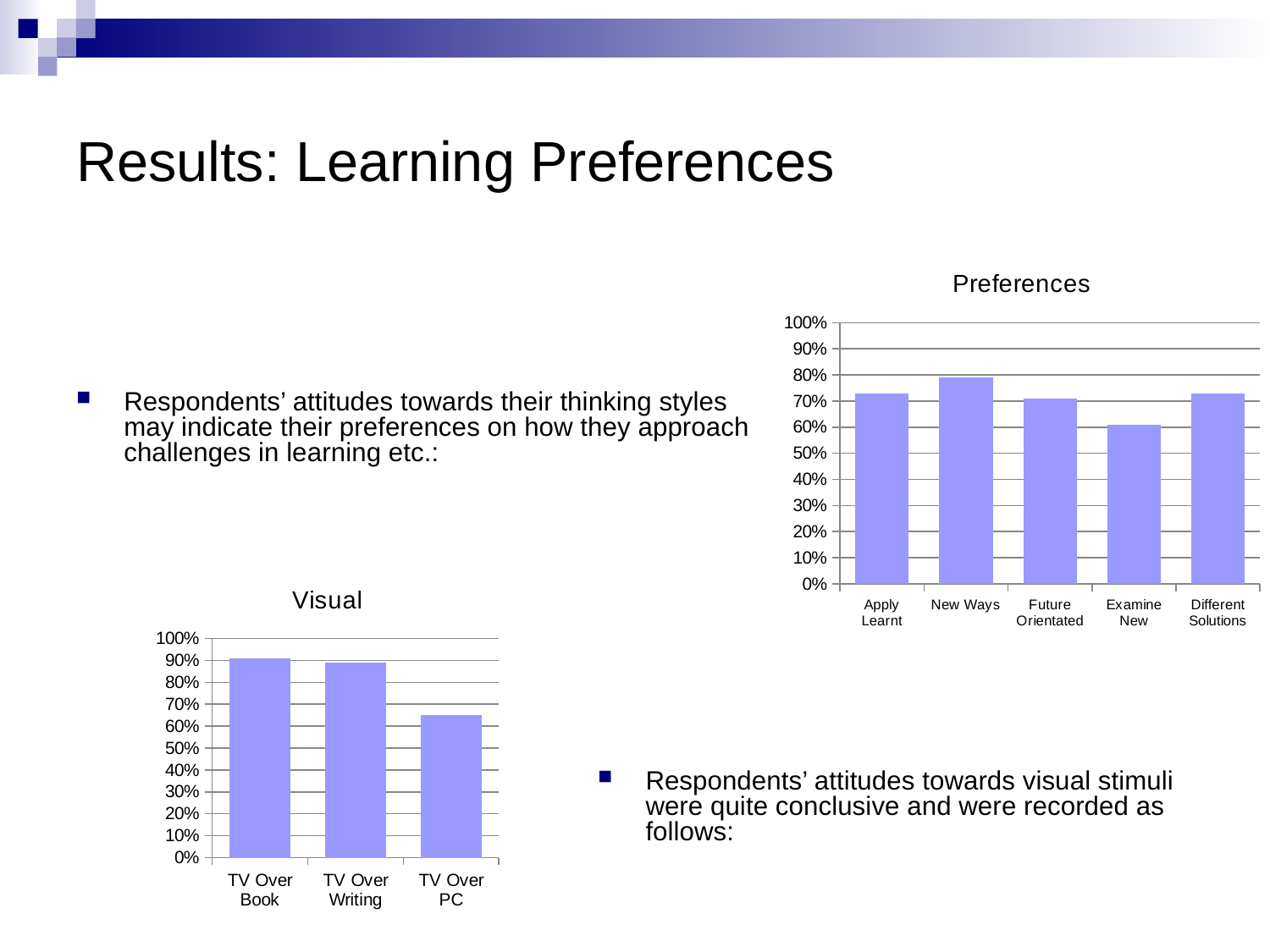
What kind of chart is the Preferences chart? bar chart In the Visual chart, which category has the lowest value? TV Over PC In the Preferences chart, which category has the highest value? New Ways In the Visual chart, which is larger, TV Over Writing or TV Over PC? TV Over Writing How many categories are shown in the Visual chart? 3 How many categories are shown in the Preferences chart? 5 In the Visual chart, is the value for TV Over Book greater or less than 80%? greater In the Preferences chart, is the value for Examine New greater or less than 70%? less In the Visual chart, is the value for TV Over PC greater or less than 70%? less In the Preferences chart, which category has the lowest value? Examine New In the Preferences chart, which is larger, New Ways or Examine New? New Ways